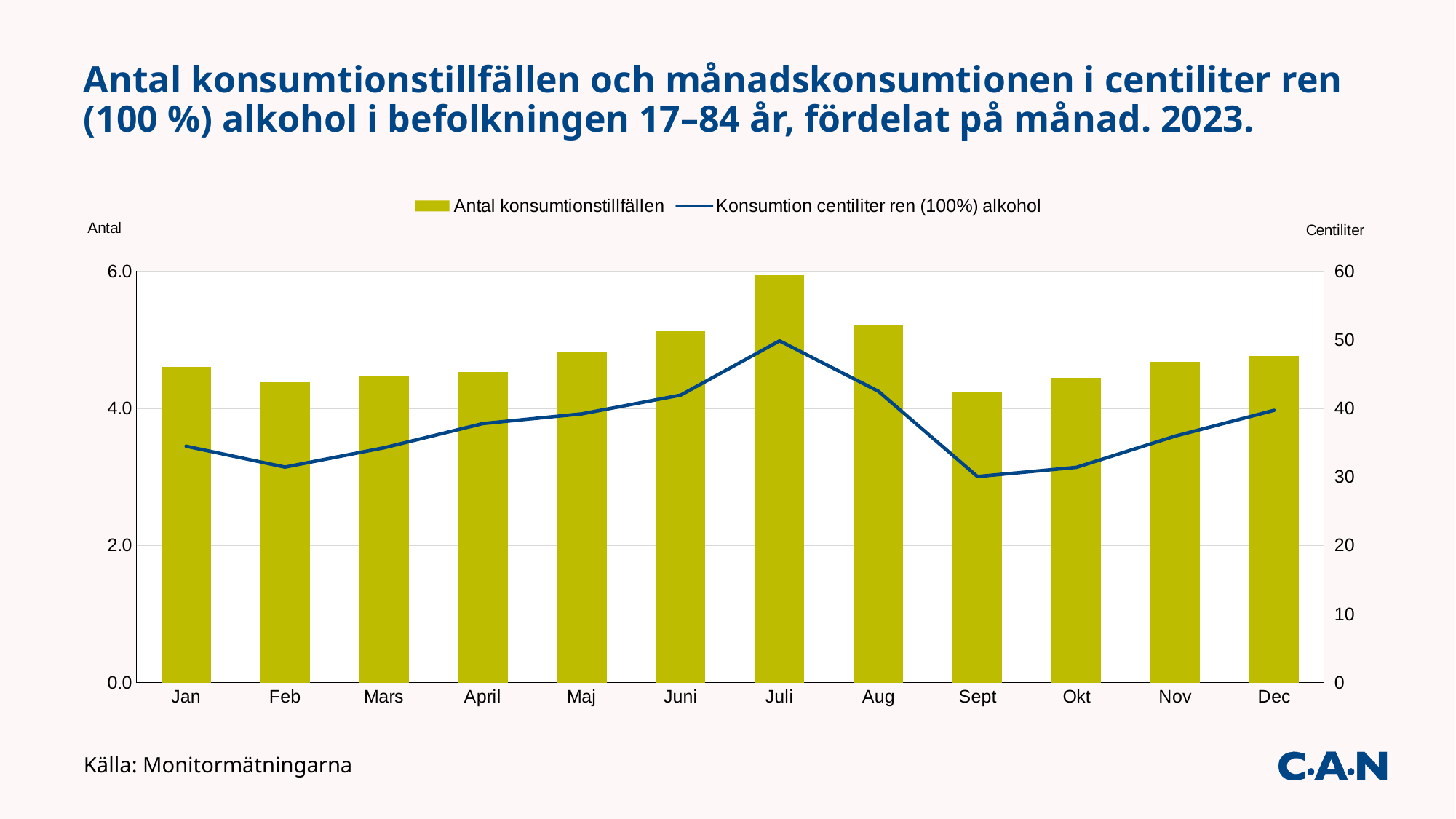
Is the value of the line for Konsumtion centiliter ren (100%) alkohol in Sept greater or less than 40? less In which month does the line for Konsumtion centiliter ren (100%) alkohol reach its highest point? Juli How many months are shown on the x axis? 12 What kind of chart is shown on the slide? A combination bar and line chart Which month has the lowest bar for Antal konsumtionstillfällen? Sept What source is cited below the chart? Källa: Monitormätningarna Which month has the highest bar for Antal konsumtionstillfällen? Juli Is the bar for Antal konsumtionstillfällen in Juli greater or less than 4.0? greater Which month has the larger bar for Antal konsumtionstillfällen, Feb or Juli? Juli Does the line for Konsumtion centiliter ren (100%) alkohol rise or fall from Feb to Juli? rise Is the value of the line for Konsumtion centiliter ren (100%) alkohol in Juli greater or less than 40? greater How many series does the legend list? 2